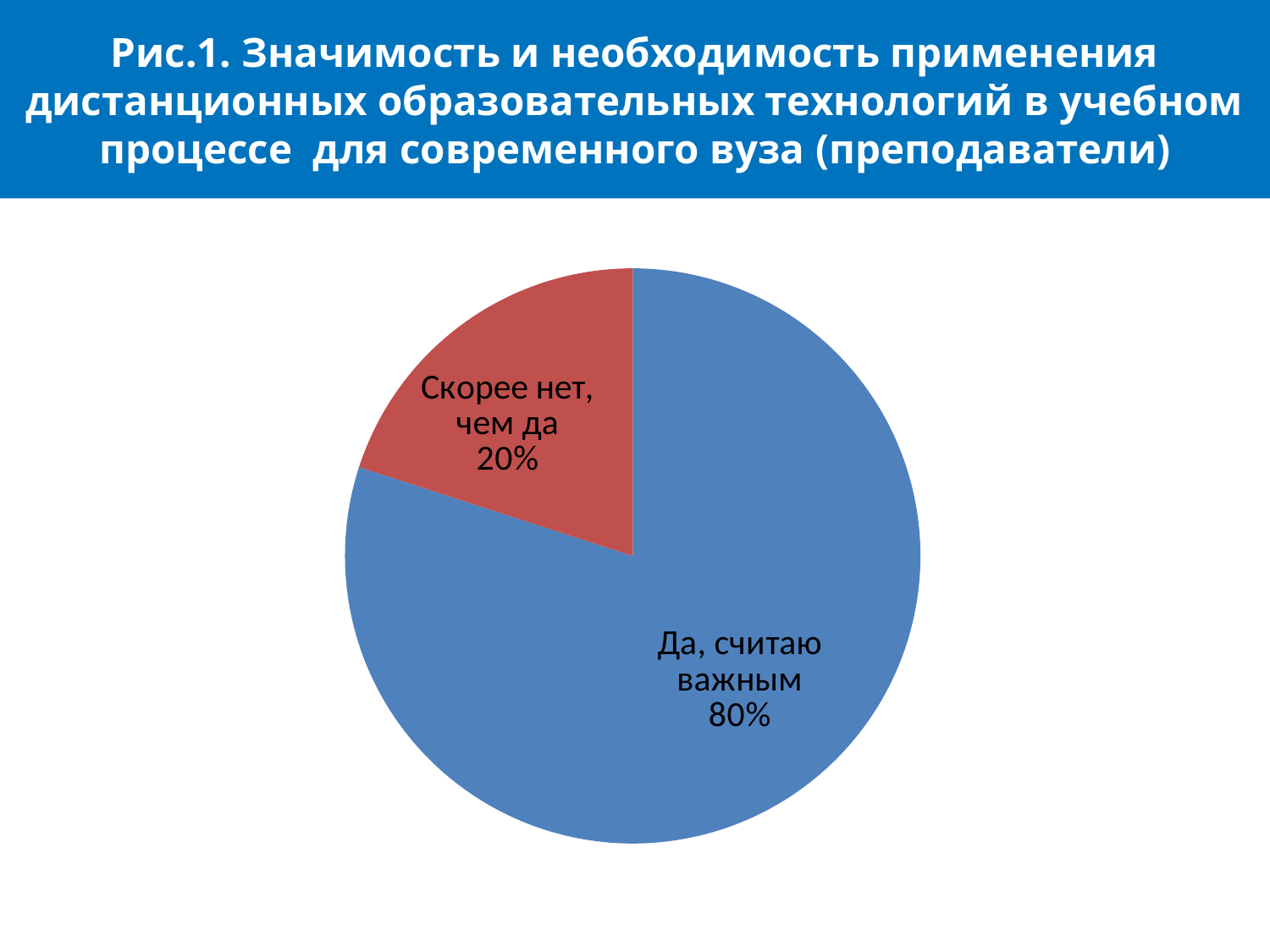
What share of the pie does "Скорее нет, чем да" represent? 20% What share of the pie does "Да, считаю важным" represent? 80% How many slices does the pie chart have? 2 What kind of chart is shown on the slide? pie chart What is the difference in percentage points between "Да, считаю важным" and "Скорее нет, чем да"? 60% Which slice of the pie is the largest? Да, считаю важным What colour is the slice for "Скорее нет, чем да"? red Which is larger: the share for "Да, считаю важным" or the share for "Скорее нет, чем да"? Да, считаю важным Is the share for "Да, считаю важным" greater or less than 50%? greater Which group of respondents does the chart title say the data is for? преподаватели Which slice of the pie is the smallest? Скорее нет, чем да